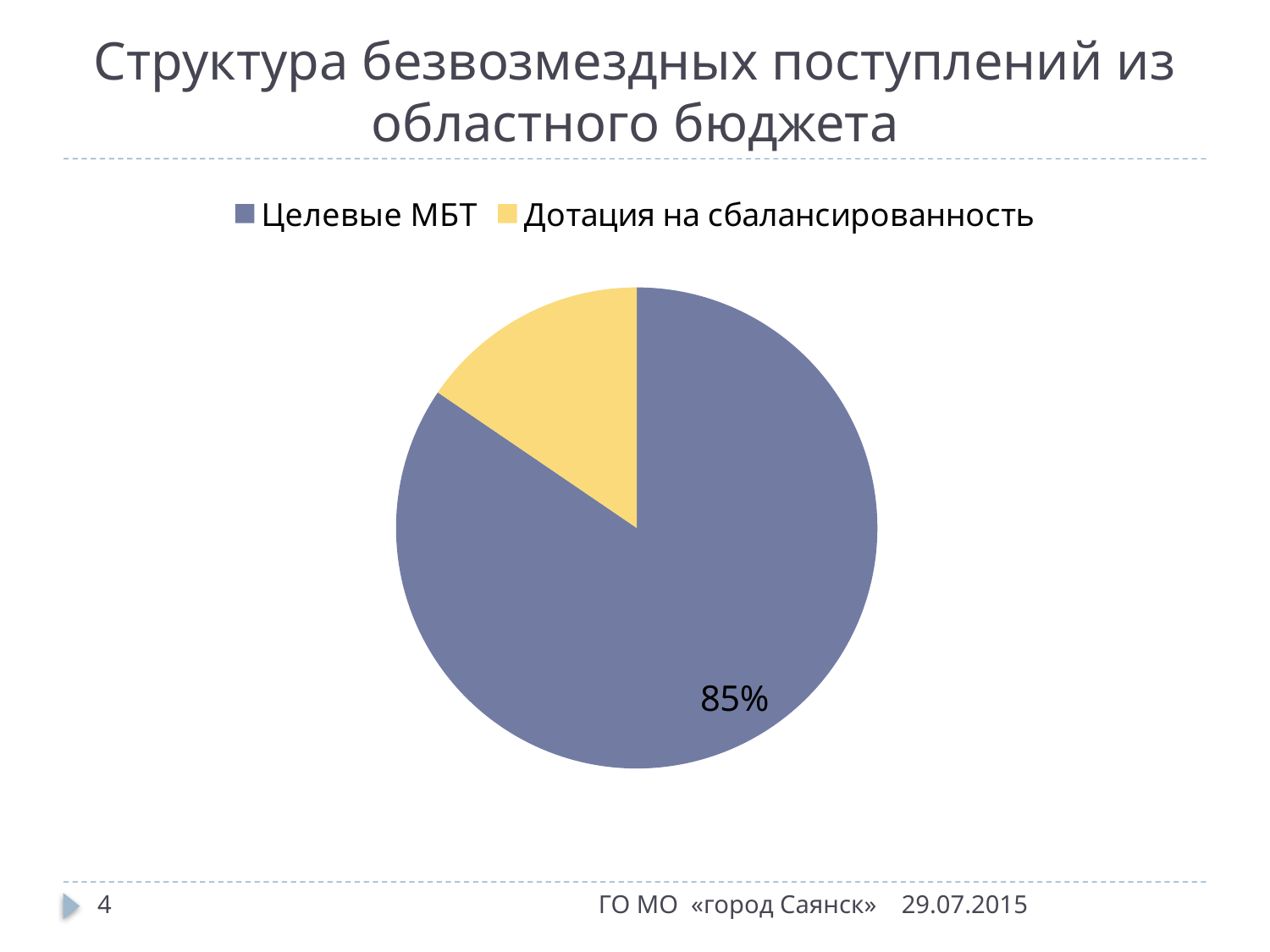
What is the title of the slide containing the pie chart? Структура безвозмездных поступлений из областного бюджета How many entries does the legend list? 2 How many slices does the pie chart have? 2 Which category has the largest slice of the pie? Целевые МБТ What share of the pie is labelled for Целевые МБТ? 85% What kind of chart is shown on the slide? pie chart Which category has the smallest slice of the pie? Дотация на сбалансированность Which is larger: the slice for Целевые МБТ or the slice for Дотация на сбалансированность? Целевые МБТ What colour is the slice for Дотация на сбалансированность? yellow